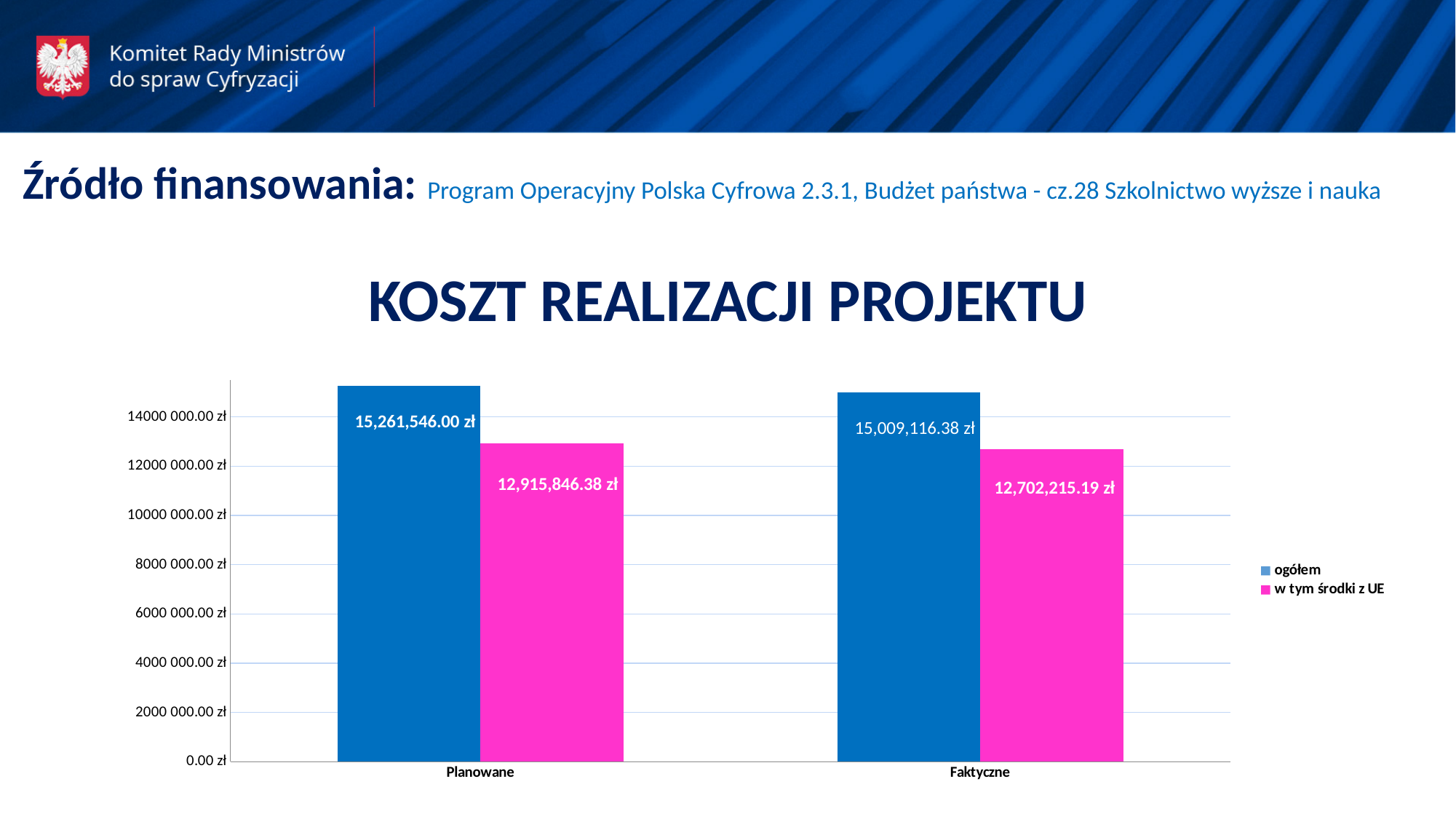
Which bar in the chart has the highest value? ogółem for Planowane How many series does the legend list? 2 What type of chart is shown on the slide? bar chart Which is larger: w tym środki z UE for Planowane or w tym środki z UE for Faktyczne? w tym środki z UE for Planowane What is the value of w tym środki z UE for Faktyczne? 12,702,215.19 zł What is the value of ogółem for Planowane? 15,261,546.00 zł Which bar in the chart has the lowest value? w tym środki z UE for Faktyczne What is the difference between ogółem and w tym środki z UE for Planowane? 2,345,699.62 zł What is the difference between the ogółem values for Planowane and Faktyczne? 252,429.62 zł How many categories are shown on the x axis? 2 What is the value of w tym środki z UE for Planowane? 12,915,846.38 zł What is the value of ogółem for Faktyczne? 15,009,116.38 zł